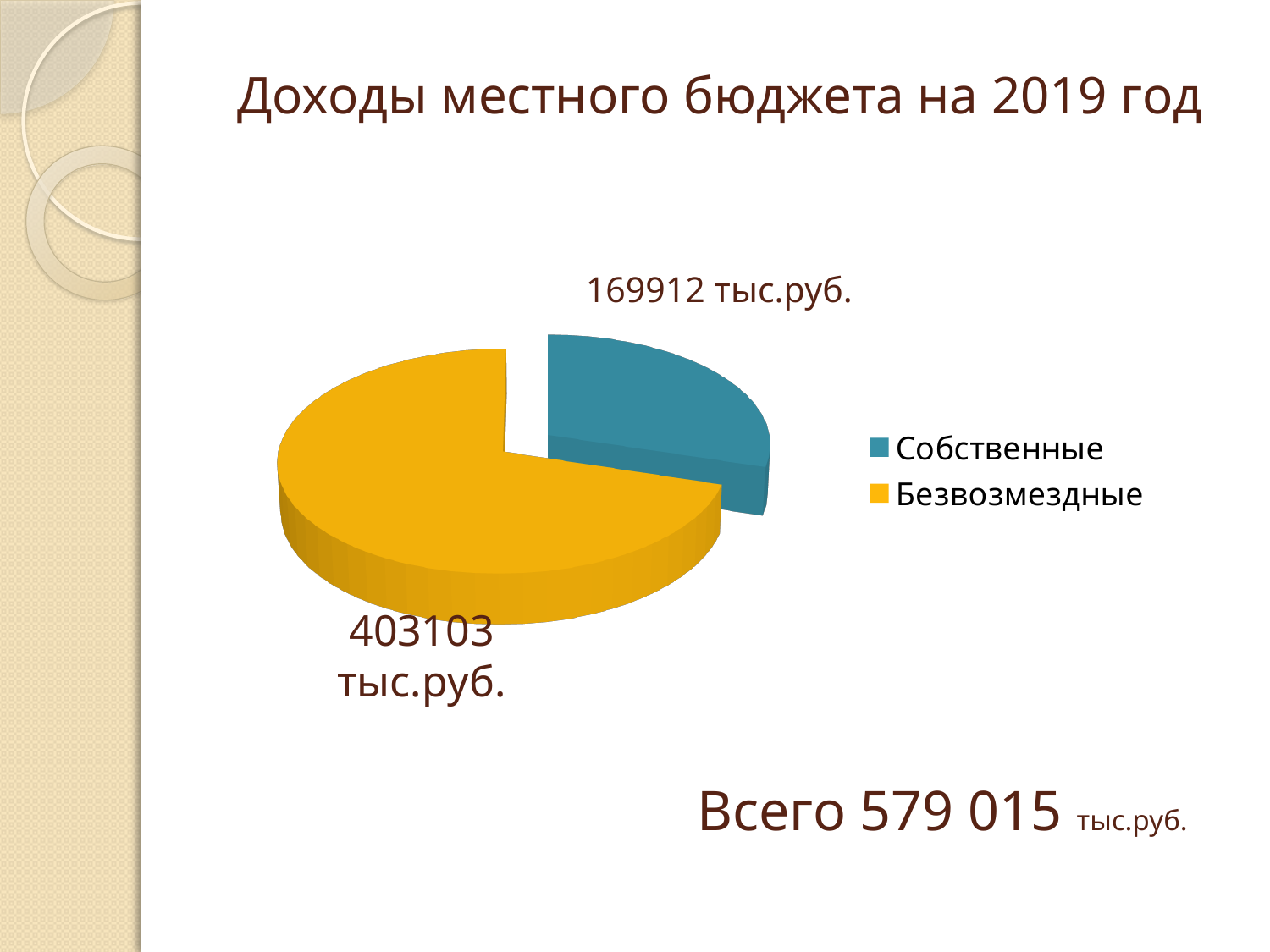
What kind of chart is shown on the slide? Pie chart What total (Всего) is stated on the slide? 579 015 тыс.руб. What colour is the slice for Безвозмездные? Yellow How many slices does the pie chart have? 2 Which category has the smallest slice of the pie? Собственные What is the title of the slide? Доходы местного бюджета на 2019 год What is the difference between the values for Безвозмездные and Собственные? 233191 тыс.руб. How many entries does the legend list? 2 Which is larger, Собственные or Безвозмездные? Безвозмездные What is the value for Безвозмездные? 403103 тыс.руб. Which category has the largest slice of the pie? Безвозмездные What is the value for Собственные? 169912 тыс.руб.